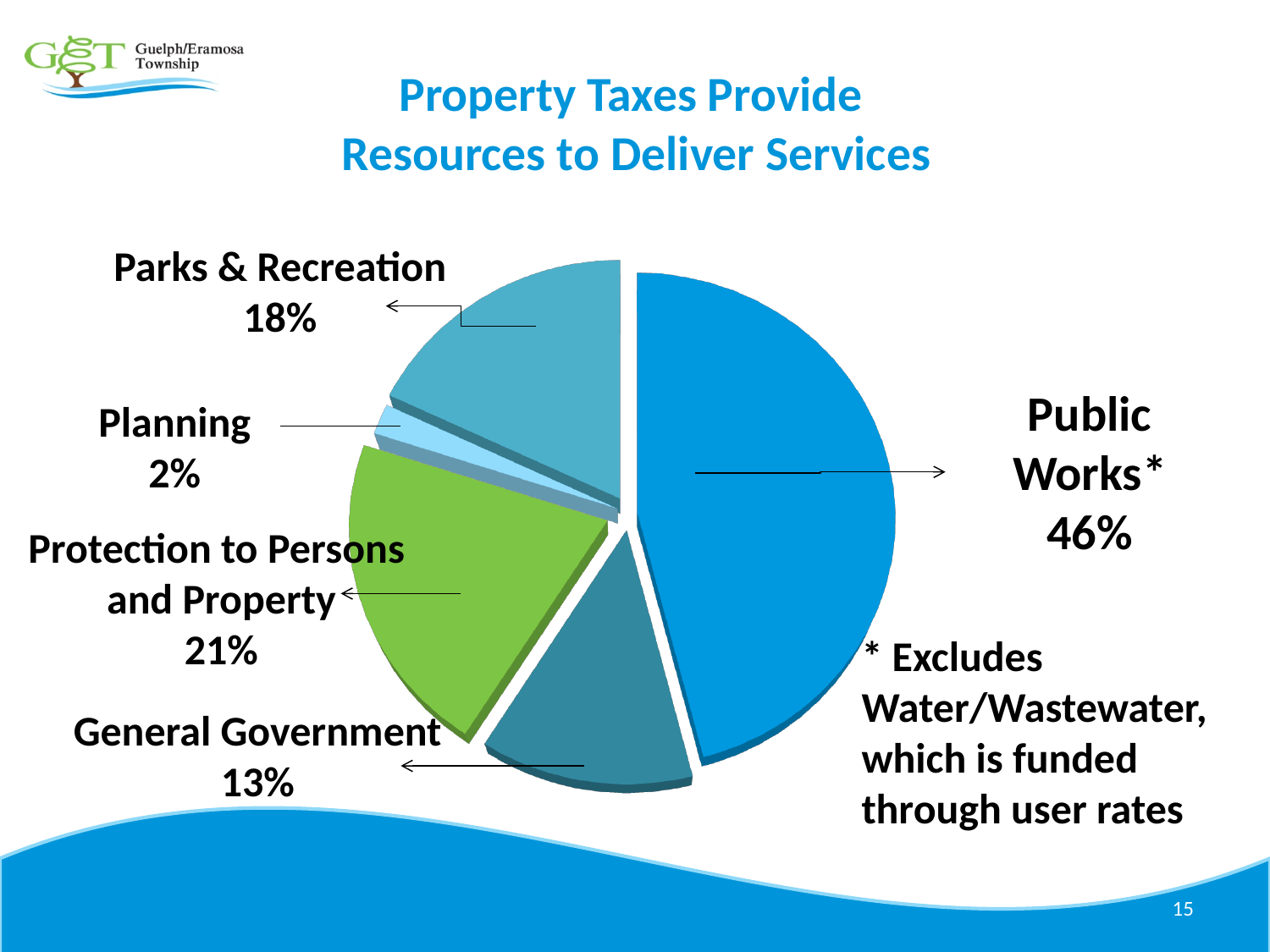
What percentage is shown for Planning? 2% Which is larger, the share for Parks & Recreation or the share for General Government? Parks & Recreation What share of property taxes goes to Public Works? 46% What kind of chart is shown on the slide? Pie chart What percentage is shown for General Government? 13% Which category has the largest share of the pie? Public Works What is the title of the chart on the slide? Property Taxes Provide Resources to Deliver Services What is the difference in percentage points between Public Works and Protection to Persons and Property? 25 What percentage is shown for Parks & Recreation? 18% Which category has the smallest share of the pie? Planning How many categories are shown in the pie chart? 5 What percentage is shown for Protection to Persons and Property? 21%